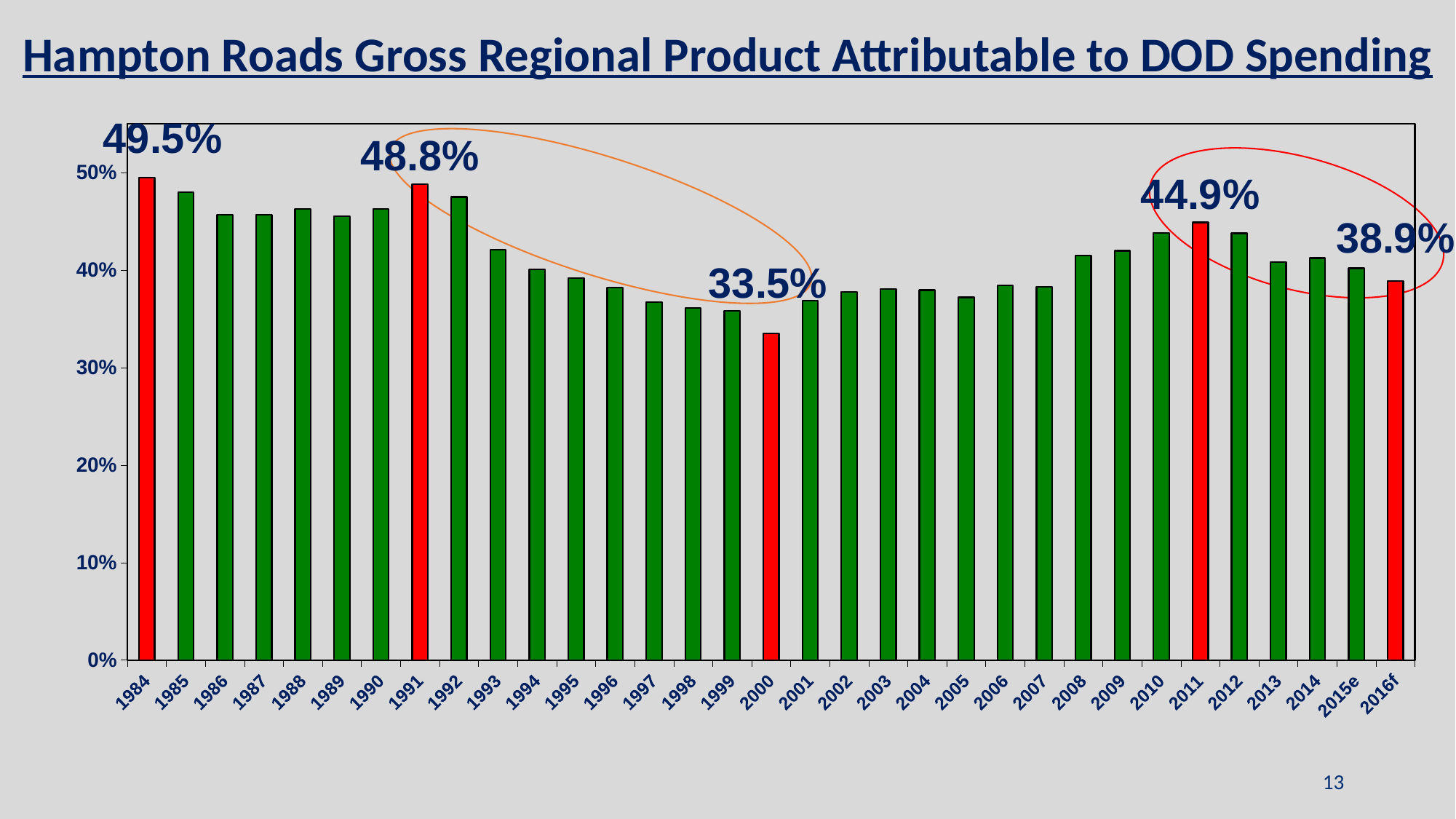
What is the value for 1984? 49.5% Do the values rise or fall from 1991 to 2000? fall What kind of chart is this? bar chart Which year has the highest value? 1984 What is the difference between the values for 1984 and 2000? 16 percentage points What is the value for 2016f? 38.9% Is the value for 2005 greater or less than 40%? less What is the value for 2011? 44.9% Which is larger, the value for 1991 or the value for 2011? 1991 Which year has the lowest value? 2000 How many years are shown on the x axis? 33 What is the value for 2000? 33.5%